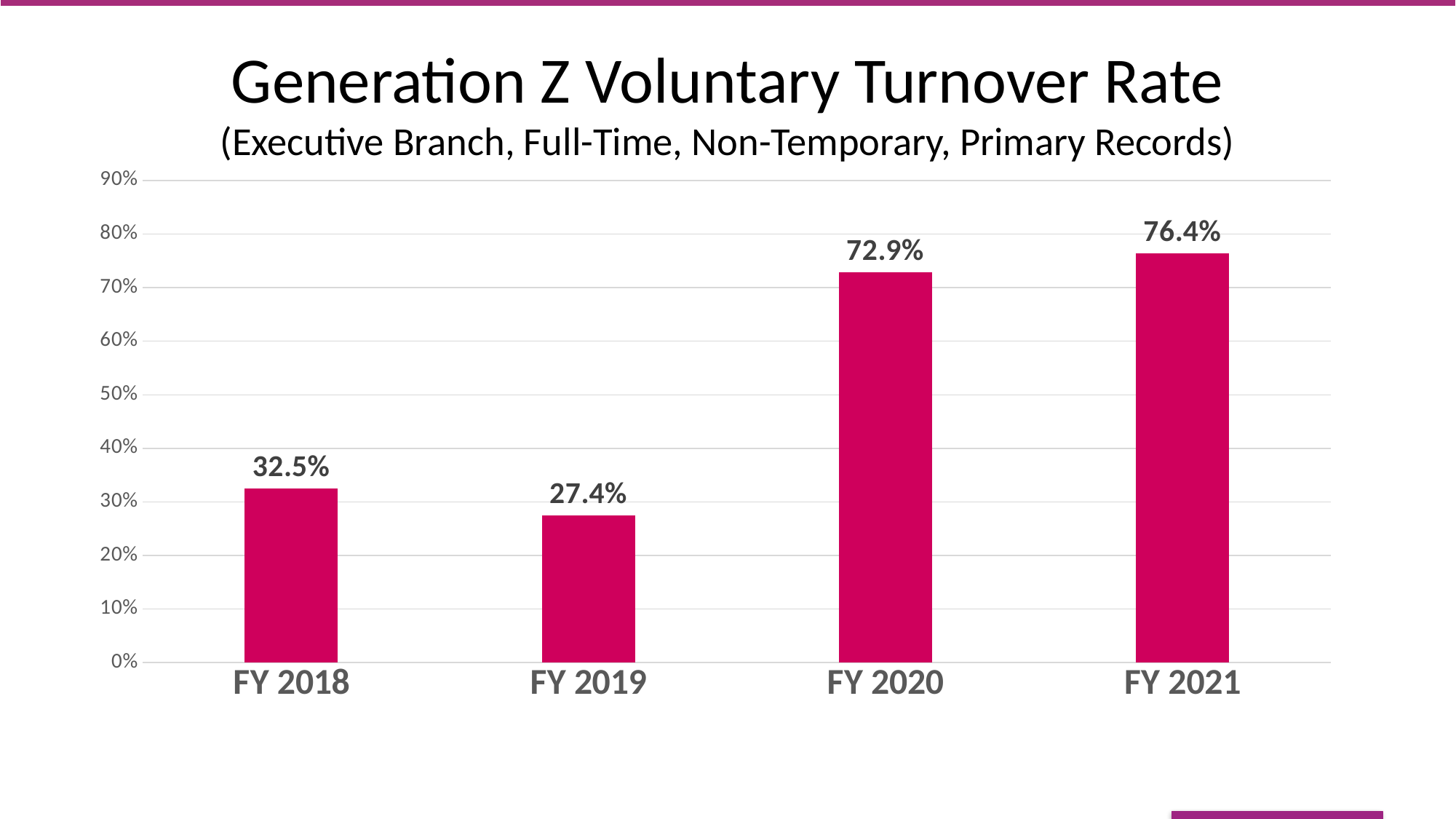
Which is larger, the turnover rate for FY 2018 or FY 2019? FY 2018 What is the difference between the FY 2021 and FY 2020 turnover rates? 3.5% What is the Generation Z voluntary turnover rate for FY 2021? 76.4% Which fiscal year has the lowest Generation Z voluntary turnover rate? FY 2019 What kind of chart is shown on the slide? Bar chart Which fiscal year has the highest Generation Z voluntary turnover rate? FY 2021 What is the Generation Z voluntary turnover rate for FY 2020? 72.9% What is the Generation Z voluntary turnover rate for FY 2018? 32.5% What is the Generation Z voluntary turnover rate for FY 2019? 27.4% What is the title of the chart? Generation Z Voluntary Turnover Rate What is the difference between the FY 2018 and FY 2019 turnover rates? 5.1% How many fiscal years are shown on the chart? 4